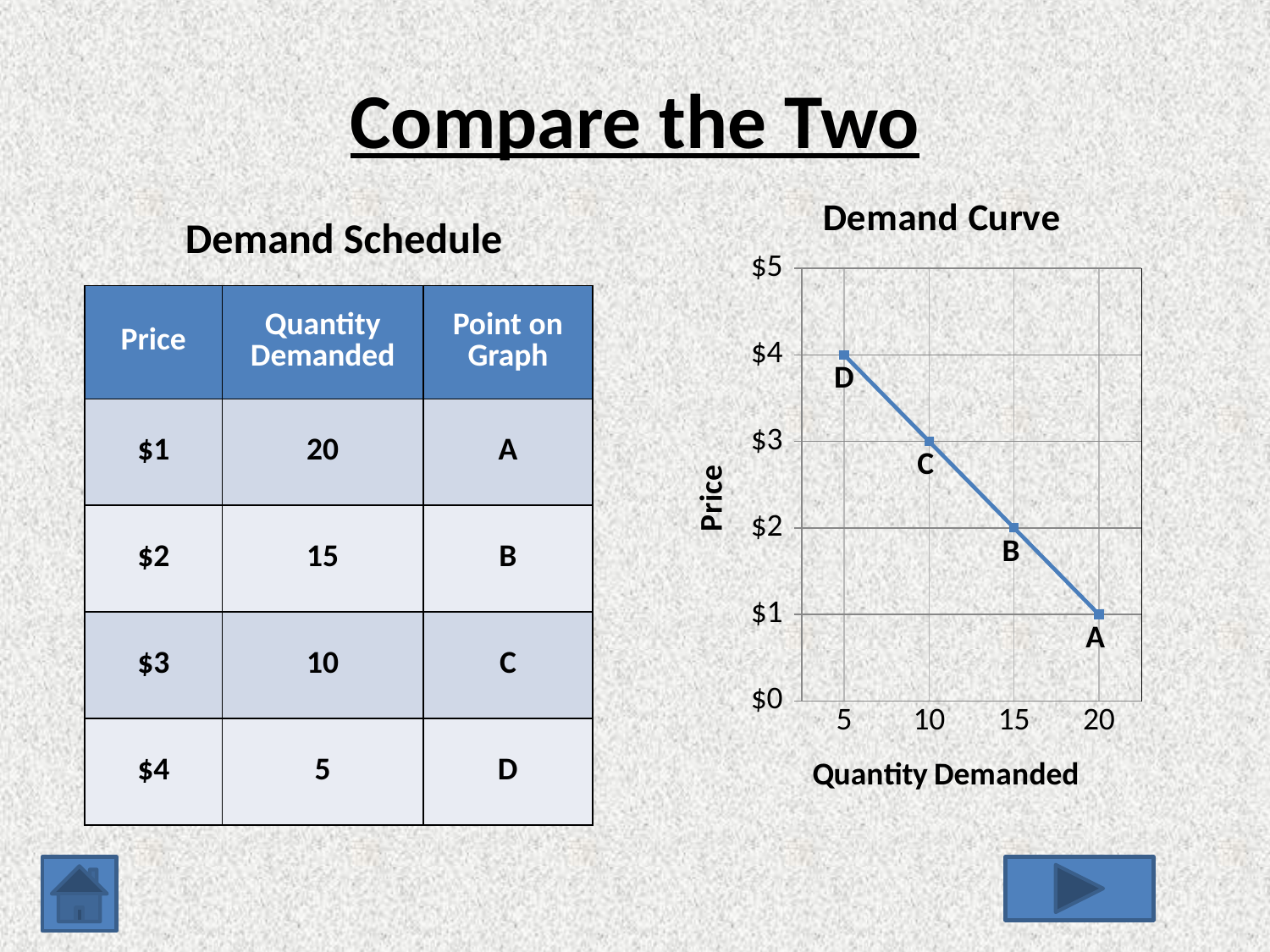
In the Demand Curve chart, what is the price at point A? $1 What kind of chart is the Demand Curve chart? line chart In the Demand Curve chart, which labelled point has the highest price? D In the Demand Curve chart, what is the price at point C? $3 In the Demand Curve chart, does the price rise or fall as quantity demanded increases along the x axis? fall In the Demand Curve chart, what is the difference in price between point D and point A? $3 In the Demand Curve chart, which point has a higher price, B or C? C In the Demand Curve chart, what is the quantity demanded at point D? 5 In the Demand Curve chart, which labelled point has the lowest quantity demanded? D In the Demand Curve chart, how many labelled points are plotted? 4 What is the title of the chart on the slide? Demand Curve In the Demand Curve chart, what is the quantity demanded at point B? 15